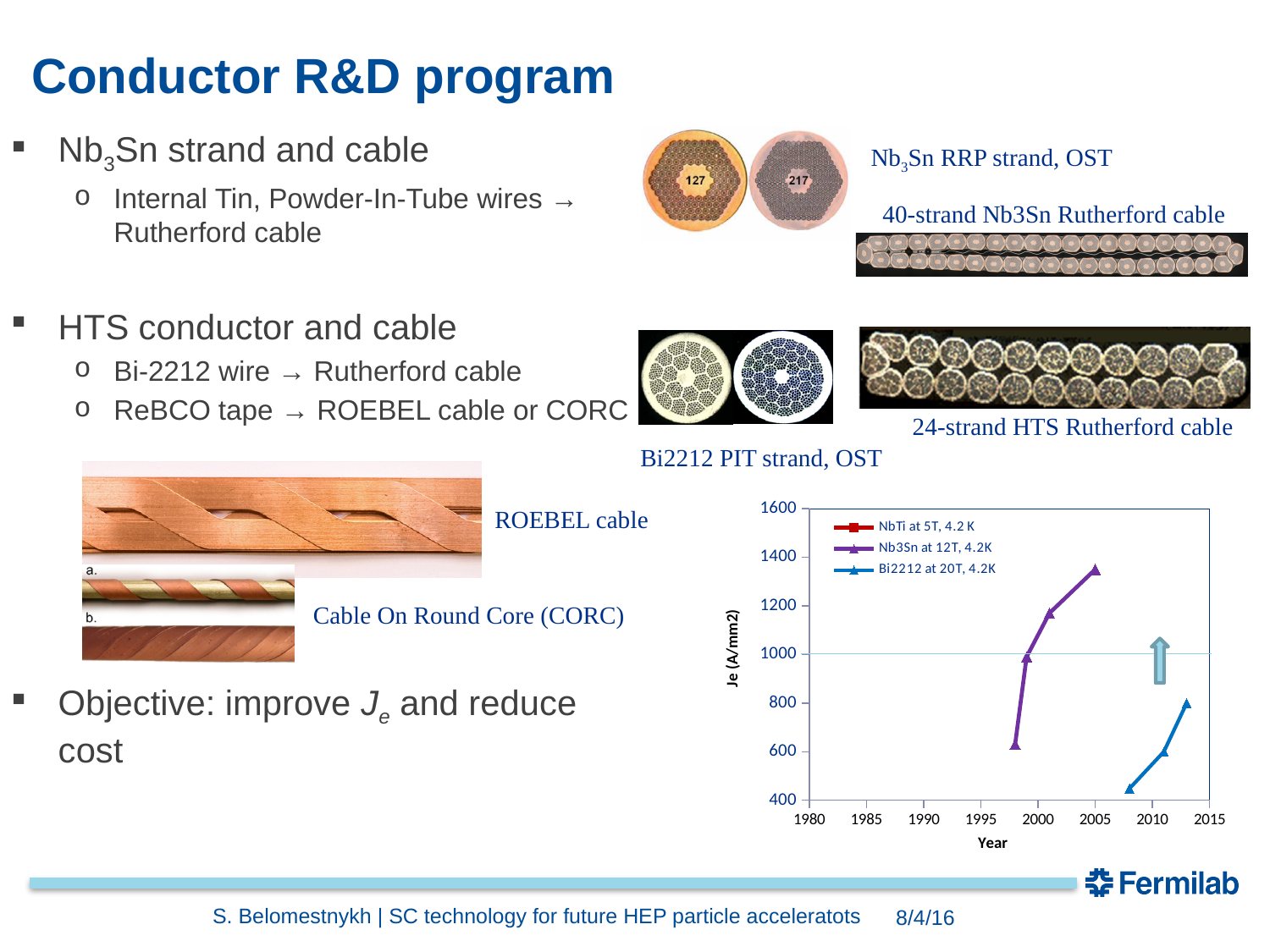
In the Je vs Year chart, is the earliest plotted Je value for Nb3Sn greater or less than 800? less In the Je vs Year chart, is the highest plotted Je value for Bi2212 greater or less than 1000? less In the Je vs Year chart, does the Je value for Bi2212 rise or fall as the year increases? rise What kind of chart is shown at the bottom right of the slide? line chart In the Je vs Year chart, is the highest plotted Je value for Nb3Sn greater or less than 1200? greater According to the legend of the Je vs Year chart, at what field is the Bi2212 series measured? 20T In the Je vs Year chart, does the Je value for Nb3Sn rise or fall as the year increases? rise What is the label of the vertical axis of the Je vs Year chart? Je (A/mm2) How many data points are plotted for the Nb3Sn series in the Je vs Year chart? 4 How many series does the legend of the Je vs Year chart list? 3 In the Je vs Year chart, which series reaches a higher Je value, Nb3Sn or Bi2212? Nb3Sn